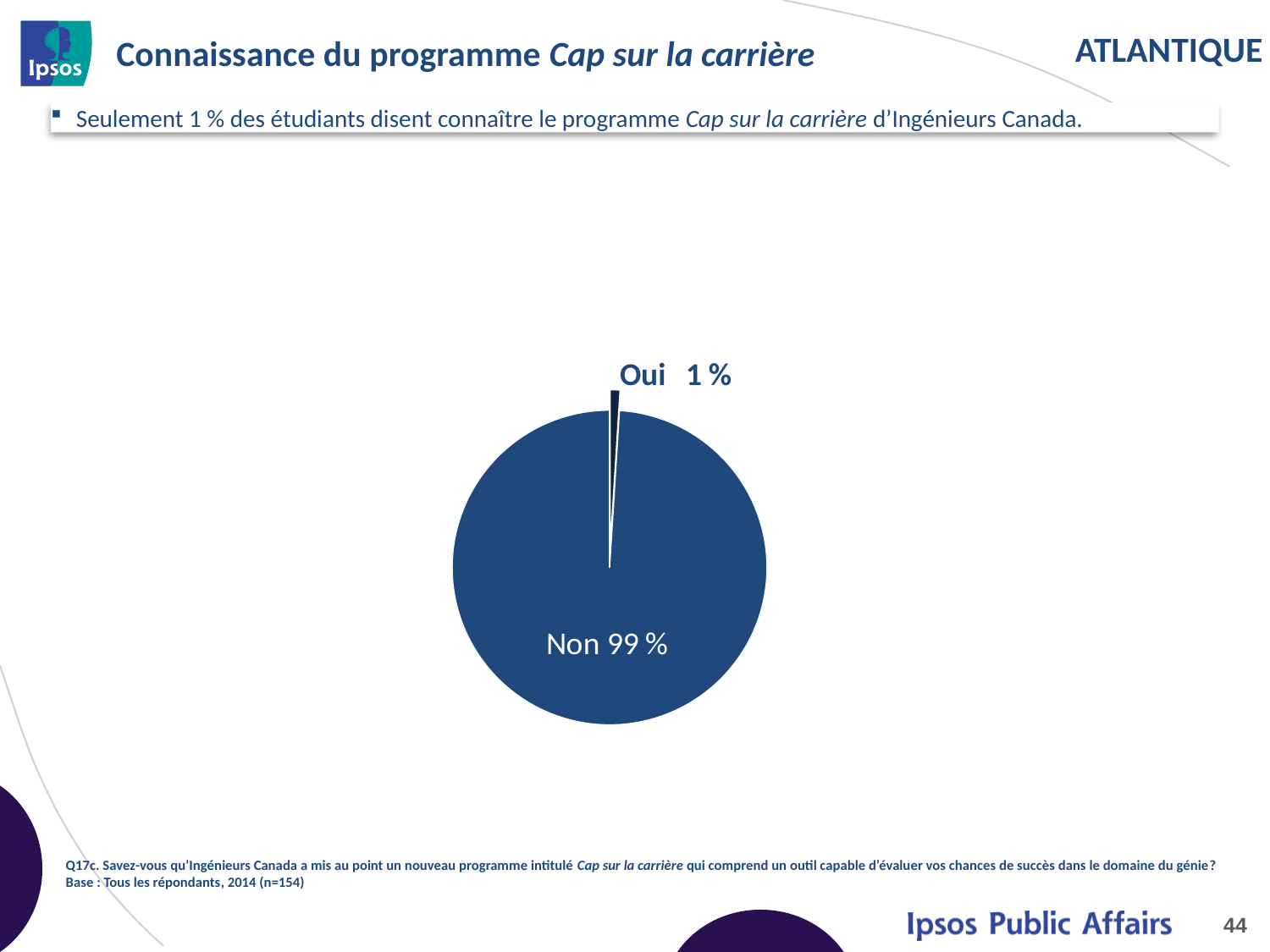
Which slice of the pie is the smallest? Oui Which slice of the pie is the largest? Non What is the value labelled for "Oui" in the pie chart? 1 % Which is larger, the "Oui" slice or the "Non" slice? Non What is the sample size (n) stated in the base note below the chart? 154 What share of the pie does "Oui" represent? 1 % What share of the pie does "Non" represent? 99 % What kind of chart is shown on the slide? pie chart What is the title of the slide containing the pie chart? Connaissance du programme Cap sur la carrière What is the difference between the "Non" and "Oui" shares? 98 % What is the value labelled for "Non" in the pie chart? 99 % How many slices does the pie chart have? 2